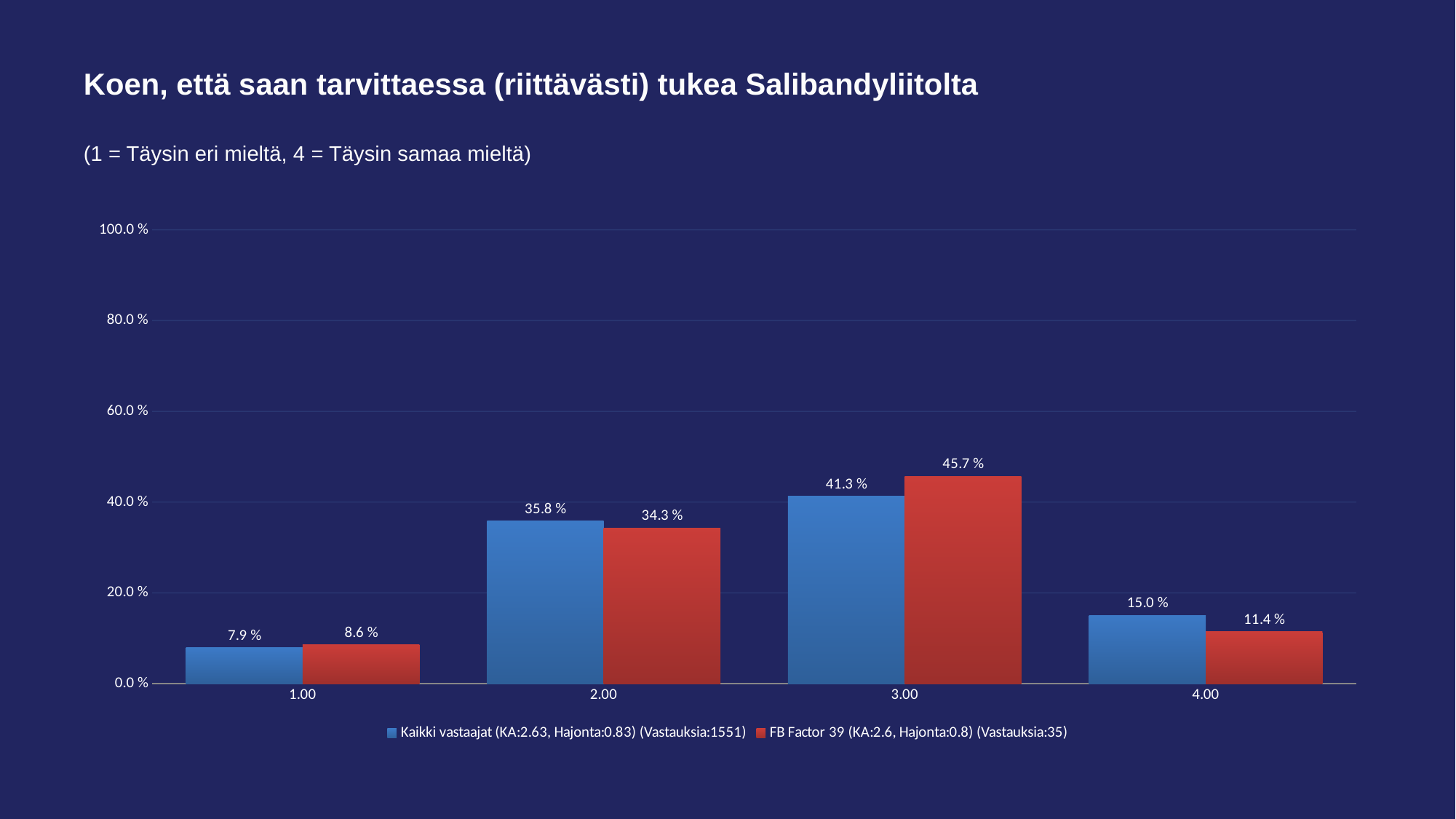
How many categories are shown on the x axis? 4 Is the value for Kaikki vastaajat at 2.00 greater or less than 20.0 %? greater Which category has the highest value for FB Factor 39? 3.00 At 4.00, which series has the larger value, Kaikki vastaajat or FB Factor 39? Kaikki vastaajat What kind of chart is shown on the slide? bar chart What colour are the bars for the FB Factor 39 series? red What is the difference between the FB Factor 39 and Kaikki vastaajat values at 3.00? 4.4 % What is the value for FB Factor 39 at 4.00? 11.4 % What is the value for FB Factor 39 at 2.00? 34.3 % What is the value for Kaikki vastaajat at 3.00? 41.3 % How many series does the legend list? 2 Which category has the lowest value for Kaikki vastaajat? 1.00